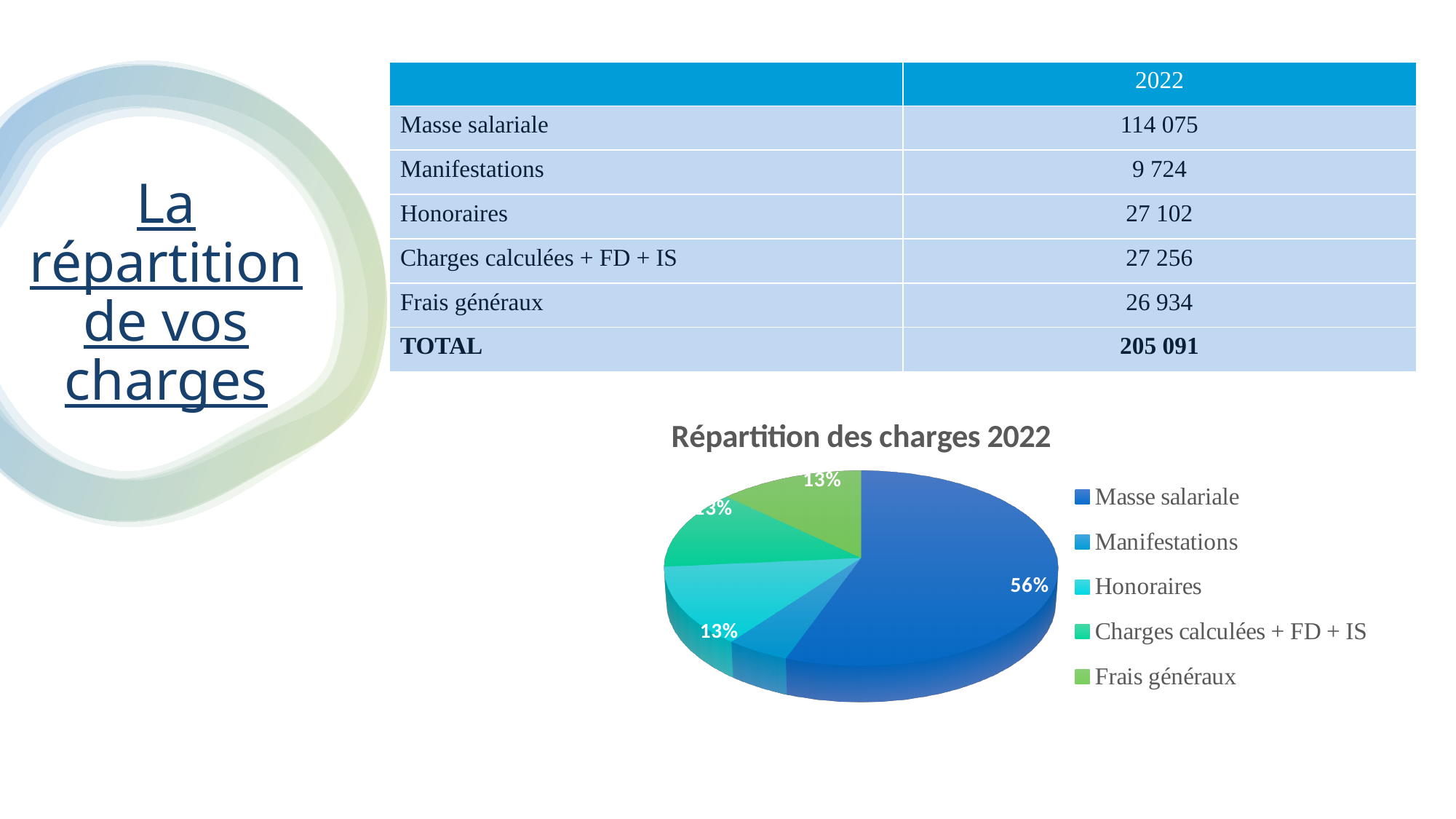
Is the share for Masse salariale greater or less than 50%? greater What share of the pie does Frais généraux represent? 13% Which category is shown in the darkest blue colour in the pie chart? Masse salariale What kind of chart is shown on the slide? pie chart How many categories does the legend of the pie chart list? 5 What share of the pie does Masse salariale represent? 56% Which category has the smallest slice of the pie? Manifestations Which slice is larger, Masse salariale or Manifestations? Masse salariale What is the difference in percentage points between the Masse salariale slice and the Frais généraux slice? 43 What is the title of the chart? Répartition des charges 2022 Which category has the largest slice of the pie? Masse salariale What share of the pie does Honoraires represent? 13%